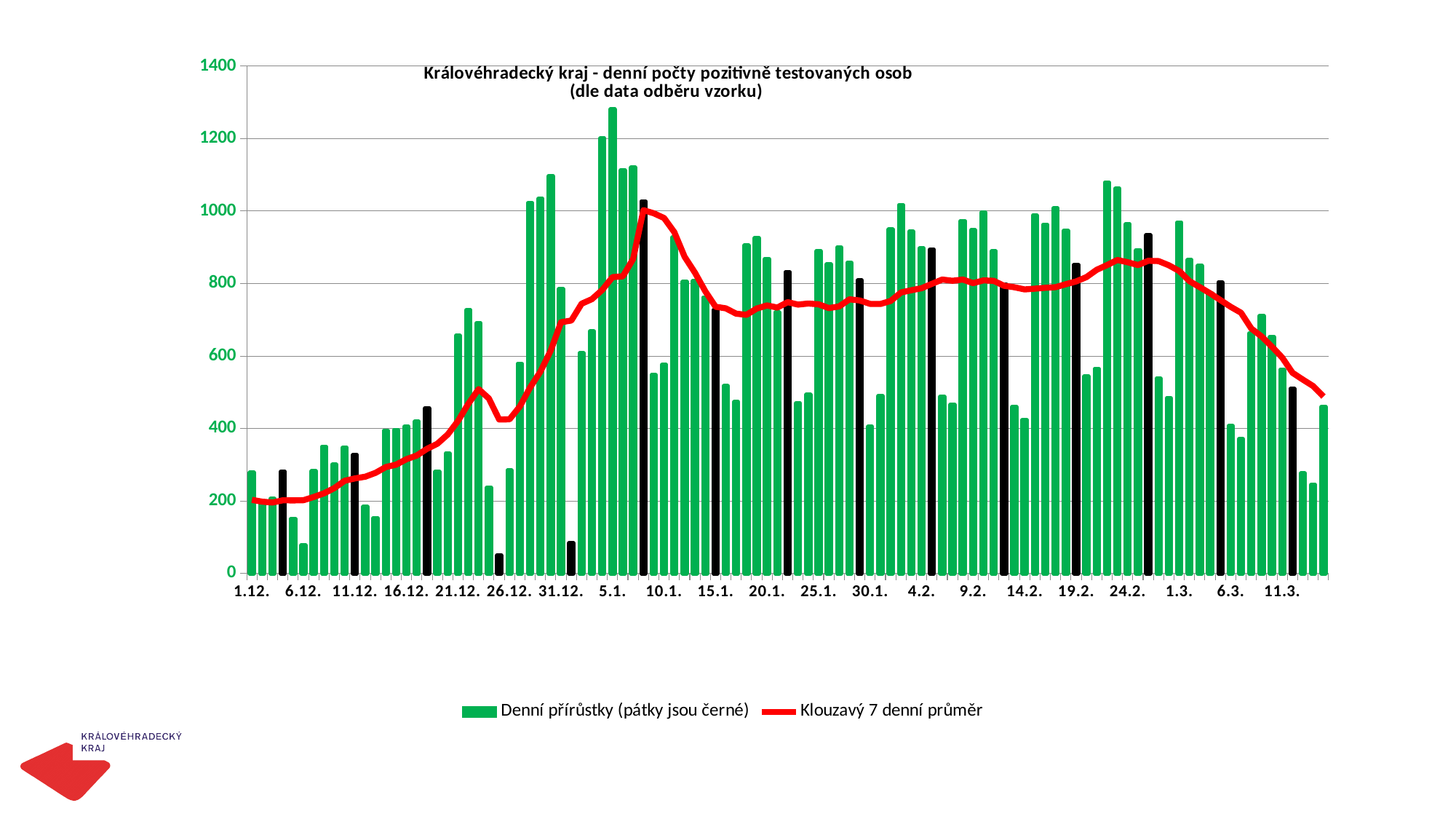
Is the value for 1.12. greater or less than 400? less Is the value for 15.1. greater or less than 600? greater Which is larger, the value for 1.12. or the value for 21.12.? 21.12. Is the value for 24.2. greater or less than 800? greater What kind of chart is shown on the slide? bar chart with a line Does the 7-day moving average line rise or fall between 1.12. and 5.1.? rise According to the legend, what colour are the bars for Fridays? black How many series does the legend list? 2 What is the title of the chart? Královéhradecký kraj - denní počty pozitivně testovaných osob (dle data odběru vzorku)